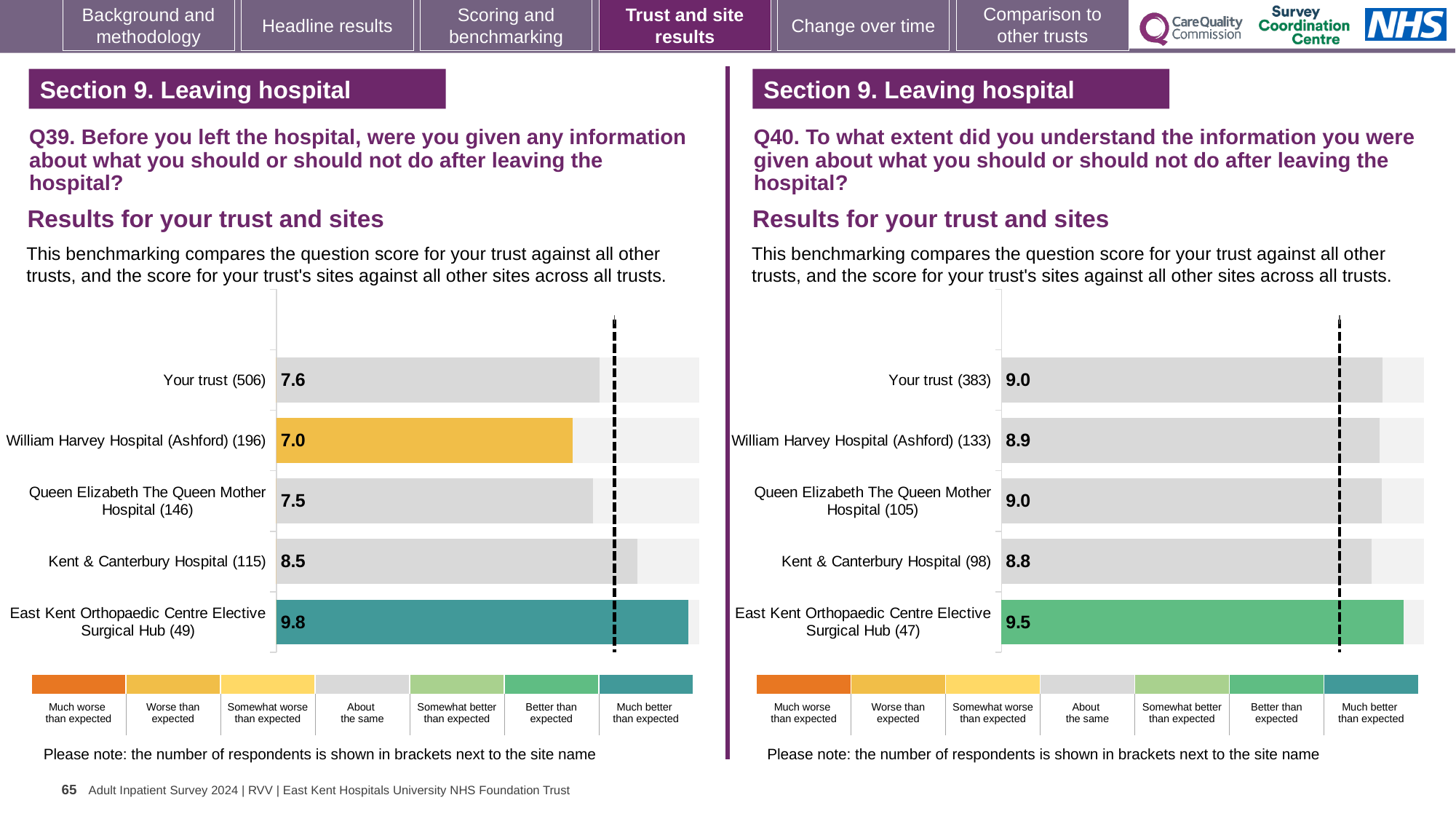
In the Q39 chart on the left, which site has the lowest score? William Harvey Hospital (Ashford) (196) How many bars are plotted in the Q39 chart on the left? 5 In the Q39 chart on the left, which has the higher score: Kent & Canterbury Hospital (115) or Your trust (506)? Kent & Canterbury Hospital (115) In the Q40 chart on the right, what is the difference between the scores for East Kent Orthopaedic Centre Elective Surgical Hub (47) and Your trust (383)? 0.5 In the Q40 chart on the right, what is the score for Kent & Canterbury Hospital (98)? 8.8 In the Q39 chart on the left, which site has the highest score? East Kent Orthopaedic Centre Elective Surgical Hub (49) In the Q39 chart on the left, what is the score for Your trust (506)? 7.6 What type of chart is used for the Q40 results on the right? Bar chart In the Q39 chart on the left, what is the difference between the scores for Kent & Canterbury Hospital (115) and Queen Elizabeth The Queen Mother Hospital (146)? 1.0 In the Q39 chart on the left, what is the score for William Harvey Hospital (Ashford) (196)? 7.0 In the Q40 chart on the right, which site has the highest score? East Kent Orthopaedic Centre Elective Surgical Hub (47) In the Q40 chart on the right, what is the score for East Kent Orthopaedic Centre Elective Surgical Hub (47)? 9.5